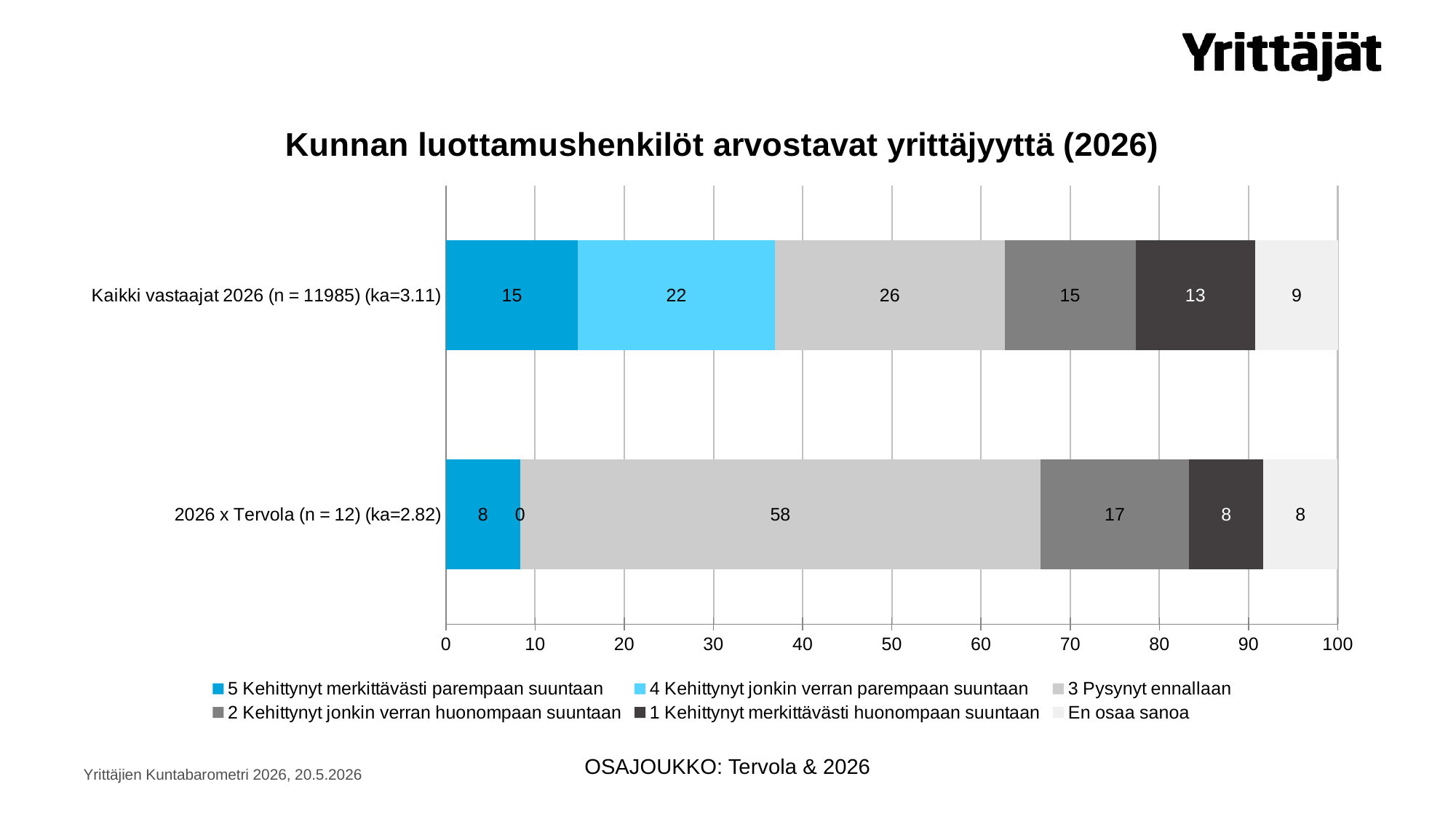
Which series has the lowest value for '2026 x Tervola (n = 12) (ka=2.82)'? 4 Kehittynyt jonkin verran parempaan suuntaan What is the value of '3 Pysynyt ennallaan' for '2026 x Tervola (n = 12) (ka=2.82)'? 58 Which series has the highest value for '2026 x Tervola (n = 12) (ka=2.82)'? 3 Pysynyt ennallaan What is the difference between the '3 Pysynyt ennallaan' values for '2026 x Tervola (n = 12) (ka=2.82)' and 'Kaikki vastaajat 2026 (n = 11985) (ka=3.11)'? 32 How many categories (bars) are plotted in the chart? 2 What is the value of '1 Kehittynyt merkittävästi huonompaan suuntaan' for 'Kaikki vastaajat 2026 (n = 11985) (ka=3.11)'? 13 Which category has the larger value for '5 Kehittynyt merkittävästi parempaan suuntaan': 'Kaikki vastaajat 2026 (n = 11985) (ka=3.11)' or '2026 x Tervola (n = 12) (ka=2.82)'? Kaikki vastaajat 2026 (n = 11985) (ka=3.11) What kind of chart is shown on the slide? stacked bar chart What is the title of the chart? Kunnan luottamushenkilöt arvostavat yrittäjyyttä (2026) What is the value of '4 Kehittynyt jonkin verran parempaan suuntaan' for 'Kaikki vastaajat 2026 (n = 11985) (ka=3.11)'? 22 What is the value of '2 Kehittynyt jonkin verran huonompaan suuntaan' for '2026 x Tervola (n = 12) (ka=2.82)'? 17 How many series does the legend list? 6